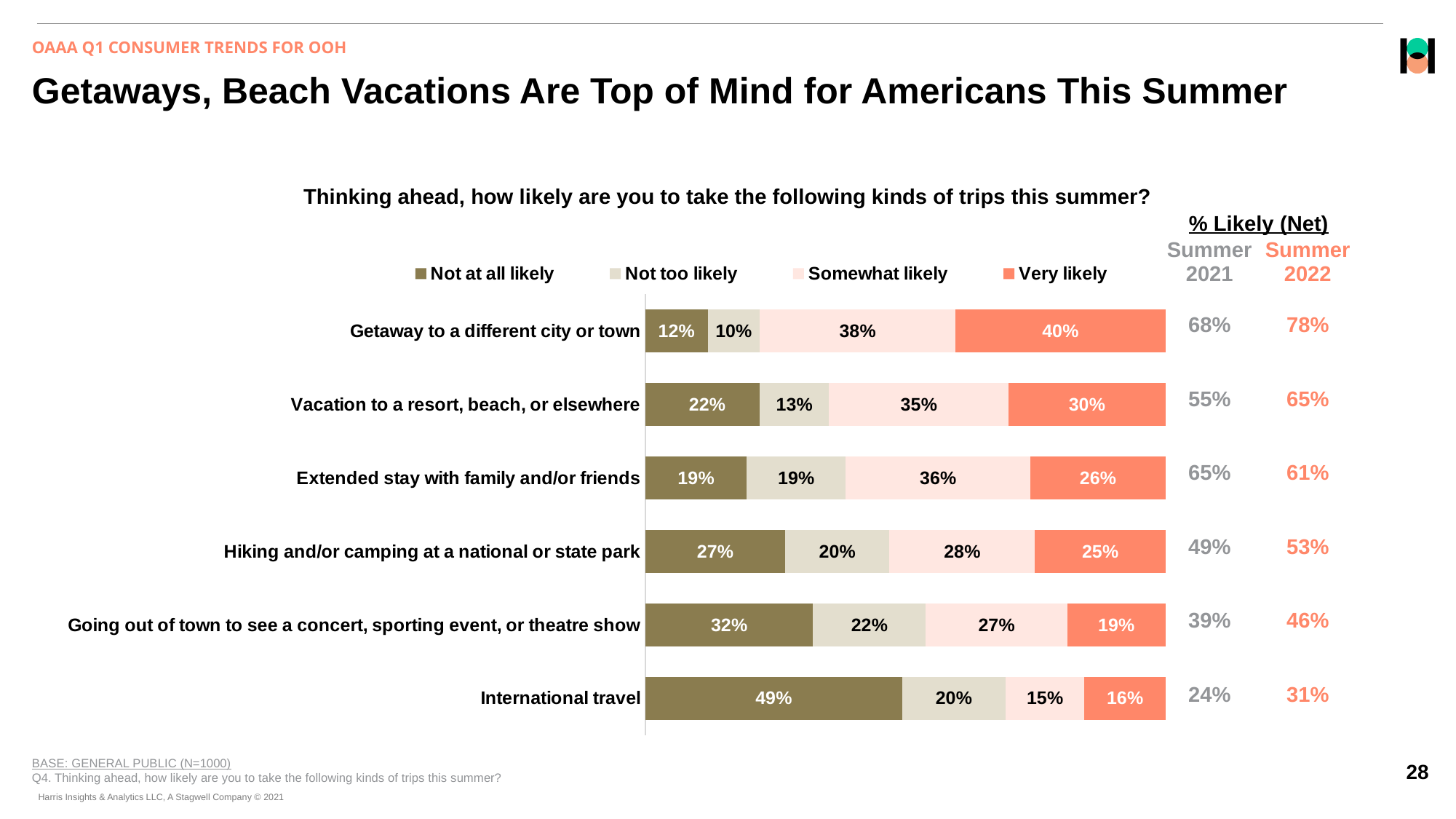
How many series does the legend list? 4 What percentage of respondents are 'Not at all likely' to take international travel? 49% Which trip type has the lowest 'Somewhat likely' percentage? International travel What percentage of respondents are 'Very likely' to take a getaway to a different city or town? 40% How many trip types are shown in the chart? 6 What kind of chart is shown on the slide? Stacked bar chart What is the combined 'Somewhat likely' and 'Very likely' percentage for vacation to a resort, beach, or elsewhere? 65% Which is larger: the 'Very likely' share for hiking and/or camping at a national or state park, or for going out of town to see a concert, sporting event, or theatre show? Hiking and/or camping at a national or state park Which trip type has the highest 'Very likely' percentage? Getaway to a different city or town What percentage of respondents are 'Somewhat likely' to take an extended stay with family and/or friends? 36% What is the difference between the 'Not at all likely' percentages for international travel and for a getaway to a different city or town? 37% Which legend entry is shown in the orange colour? Very likely